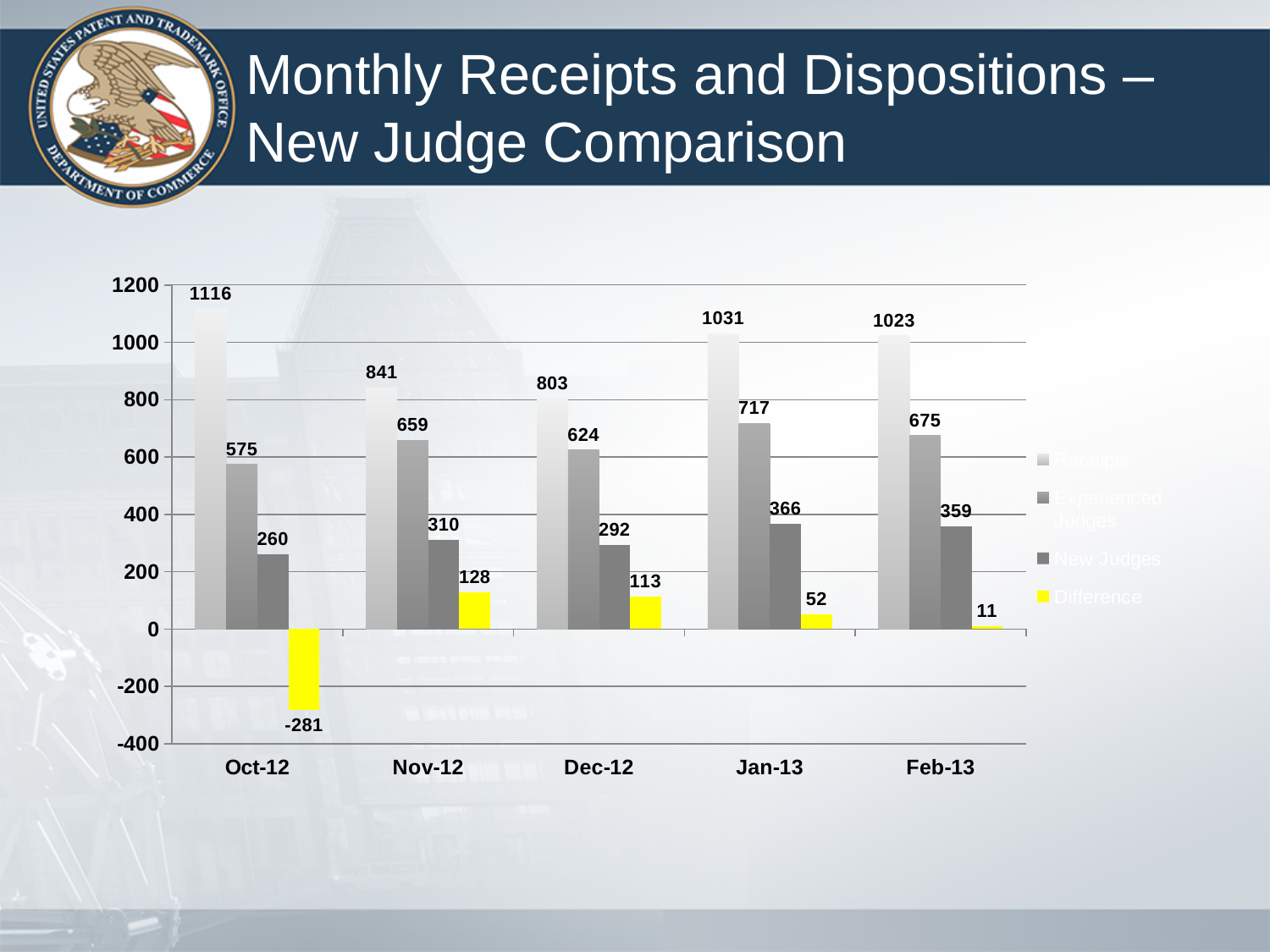
Which month has the highest Receipts value? Oct-12 How many months are shown on the x axis? 5 What is the Receipts value for Oct-12? 1116 How many series does the legend list? 4 What kind of chart is shown on the slide? Bar chart Which month has the lowest Difference value? Oct-12 Does the Difference series rise or fall from Nov-12 to Feb-13? Fall What is the Difference value for Oct-12? -281 What is the New Judges value for Jan-13? 366 What is the difference between the Receipts value and the Experienced Judges value for Nov-12? 182 What is the Experienced Judges value for Feb-13? 675 Which is larger, the Experienced Judges value for Jan-13 or for Dec-12? Jan-13